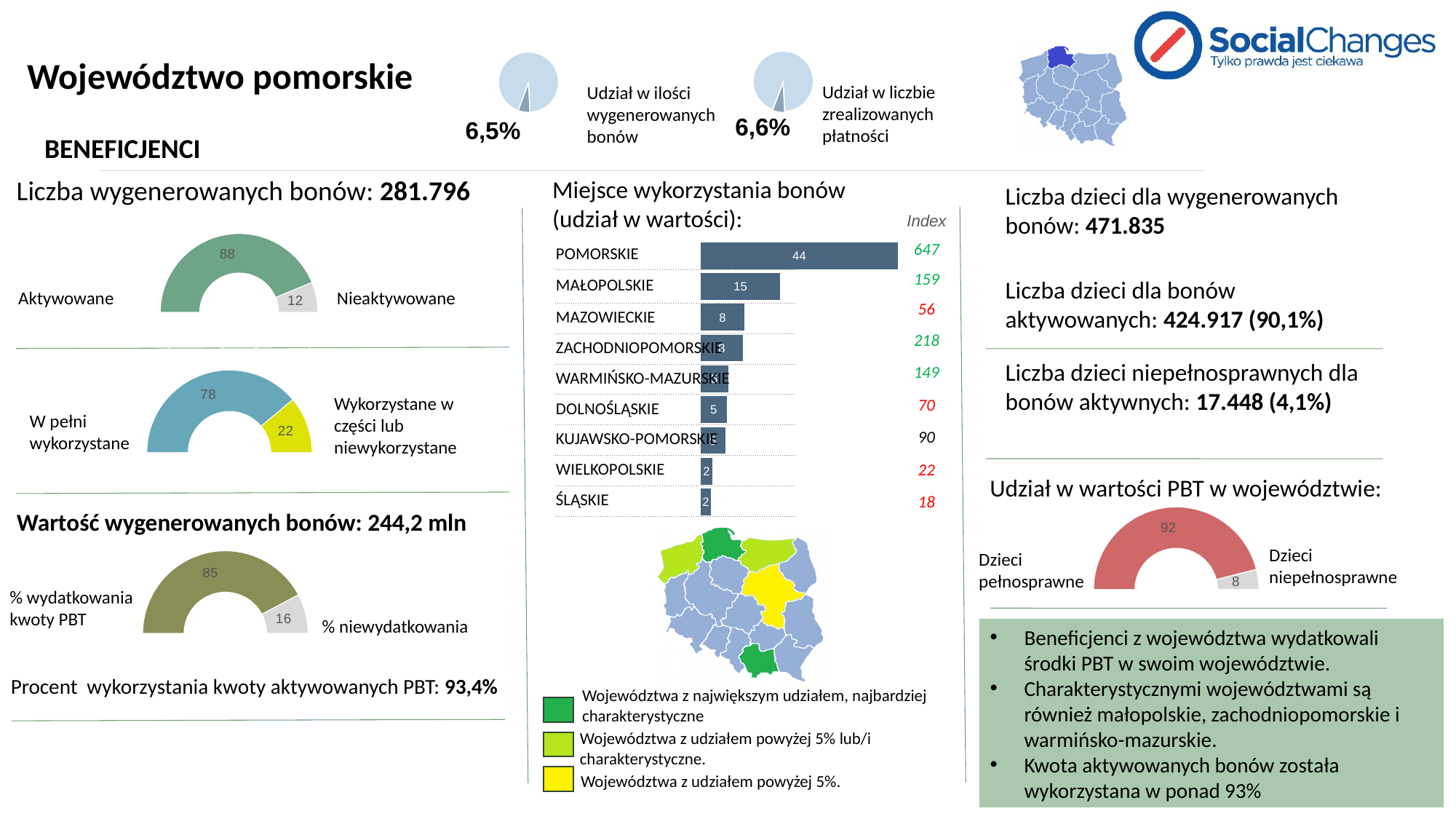
In the 'Miejsce wykorzystania bonów' chart, what is the Index value shown for POMORSKIE? 647 In the 'Udział w wartości PBT w województwie' chart, what is the value for 'Dzieci niepełnosprawne'? 8 In the semicircle chart with 'W pełni wykorzystane', what is the value for 'Wykorzystane w części lub niewykorzystane'? 22 In the 'Miejsce wykorzystania bonów (udział w wartości)' bar chart, how many voivodeships are listed? 9 In the 'Miejsce wykorzystania bonów (udział w wartości)' bar chart, what is the difference between the values for POMORSKIE and MAŁOPOLSKIE? 29 In the 'Miejsce wykorzystania bonów (udział w wartości)' bar chart, which is larger: the value for MAZOWIECKIE or the value for DOLNOŚLĄSKIE? MAZOWIECKIE In the 'Miejsce wykorzystania bonów (udział w wartości)' bar chart, what is the value for MAŁOPOLSKIE? 15 In the semicircle chart under 'Liczba wygenerowanych bonów', what is the value for Aktywowane? 88 In the 'Miejsce wykorzystania bonów (udział w wartości)' bar chart, which voivodeship has the highest value? POMORSKIE In the semicircle chart under 'Wartość wygenerowanych bonów', what is the value for '% niewydatkowania'? 16 In the 'Miejsce wykorzystania bonów (udział w wartości)' bar chart, what is the value for POMORSKIE? 44 What kind of chart is 'Miejsce wykorzystania bonów (udział w wartości)'? bar chart